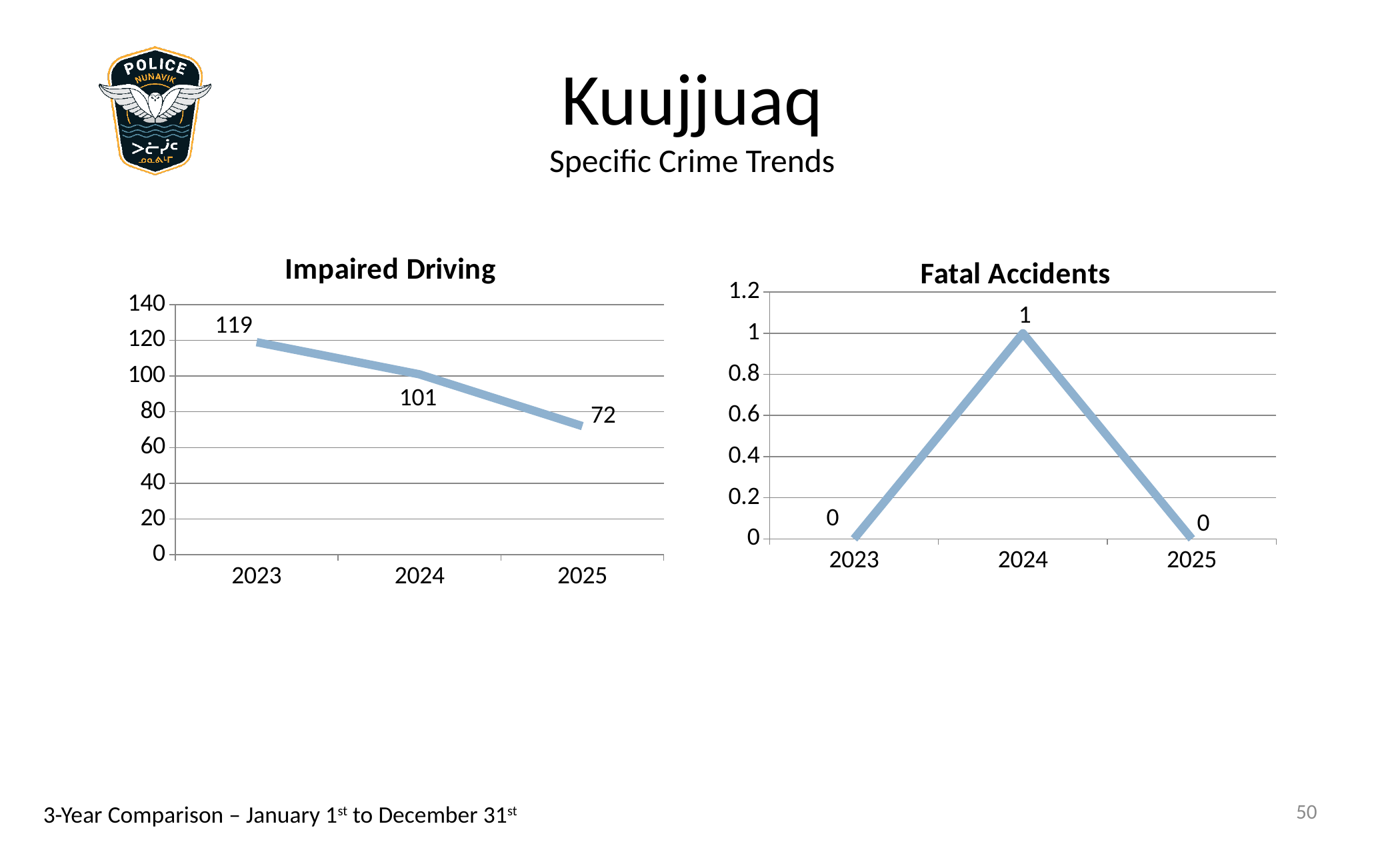
In the Impaired Driving chart, which year has the lowest value? 2025 In the Impaired Driving chart, how many years are plotted? 3 In the Impaired Driving chart, which year has the highest value? 2023 In the Fatal Accidents chart, which year has the highest value? 2024 In the Fatal Accidents chart, what is the value for 2024? 1 In the Impaired Driving chart, what is the value for 2023? 119 In the Fatal Accidents chart, what is the value for 2023? 0 In the Impaired Driving chart, do the values rise or fall from 2023 to 2025? fall What kind of chart is the Impaired Driving chart? line chart In the Impaired Driving chart, what is the value for 2025? 72 In the Impaired Driving chart, what is the difference between the 2023 and 2025 values? 47